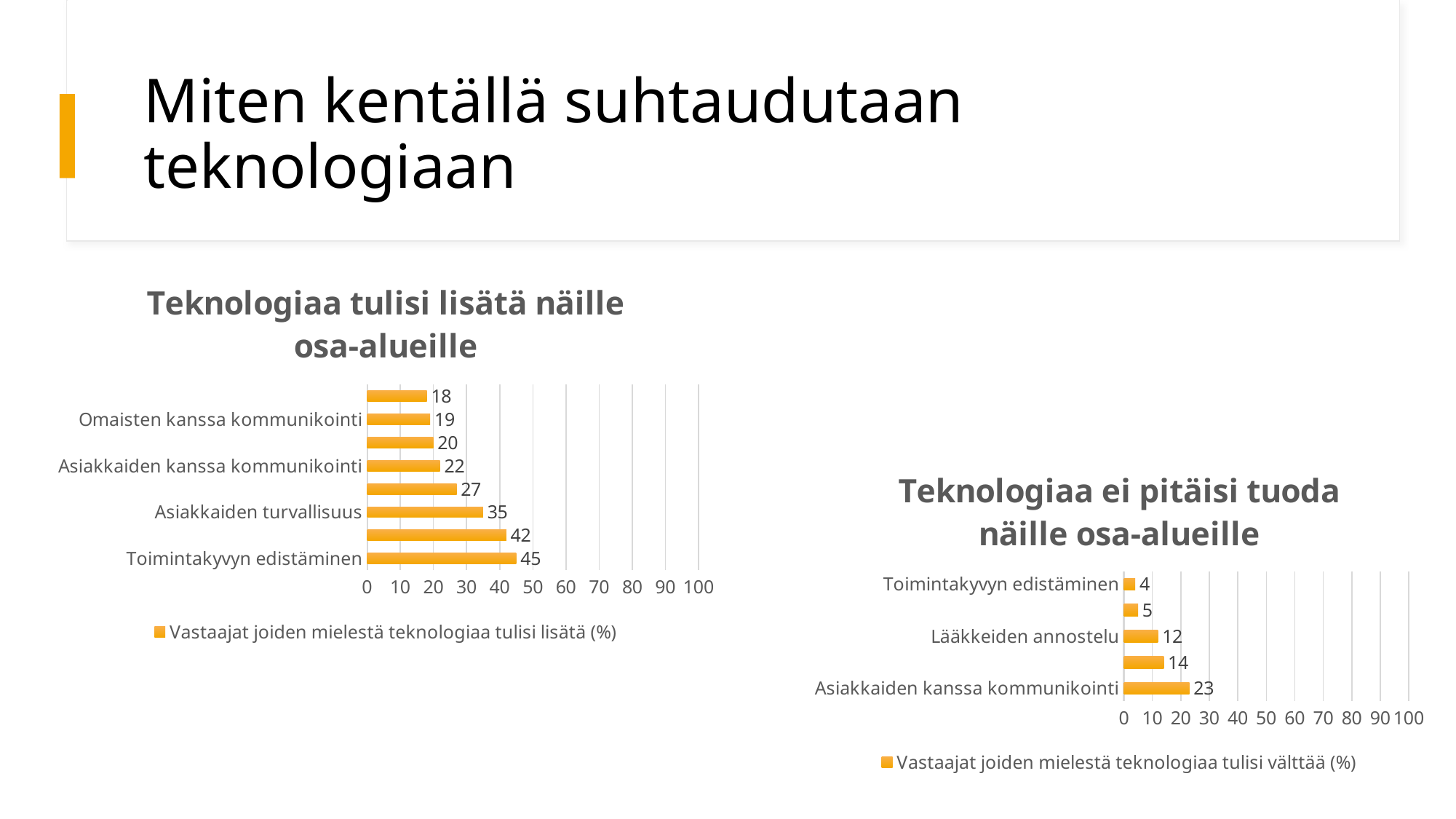
In the chart 'Teknologiaa tulisi lisätä näille osa-alueille', which labelled category has the highest value? Toimintakyvyn edistäminen In the chart 'Teknologiaa tulisi lisätä näille osa-alueille', which is larger: Asiakkaiden turvallisuus or Asiakkaiden kanssa kommunikointi? Asiakkaiden turvallisuus What kind of chart is 'Teknologiaa tulisi lisätä näille osa-alueille'? Bar chart In the chart 'Teknologiaa ei pitäisi tuoda näille osa-alueille', what is the value for Asiakkaiden kanssa kommunikointi? 23 In the chart 'Teknologiaa ei pitäisi tuoda näille osa-alueille', what is the value for Lääkkeiden annostelu? 12 In the chart 'Teknologiaa tulisi lisätä näille osa-alueille', what is the difference between Toimintakyvyn edistäminen and Asiakkaiden turvallisuus? 10 How many bars are plotted in the chart 'Teknologiaa ei pitäisi tuoda näille osa-alueille'? 5 In the chart 'Teknologiaa ei pitäisi tuoda näille osa-alueille', what is the difference between Asiakkaiden kanssa kommunikointi and Lääkkeiden annostelu? 11 In the chart 'Teknologiaa tulisi lisätä näille osa-alueille', what is the value for Omaisten kanssa kommunikointi? 19 In the chart 'Teknologiaa tulisi lisätä näille osa-alueille', what is the value for Toimintakyvyn edistäminen? 45 In the chart 'Teknologiaa ei pitäisi tuoda näille osa-alueille', which category has the lowest value? Toimintakyvyn edistäminen In the chart 'Teknologiaa tulisi lisätä näille osa-alueille', is the value for Asiakkaiden turvallisuus greater or less than 30? greater